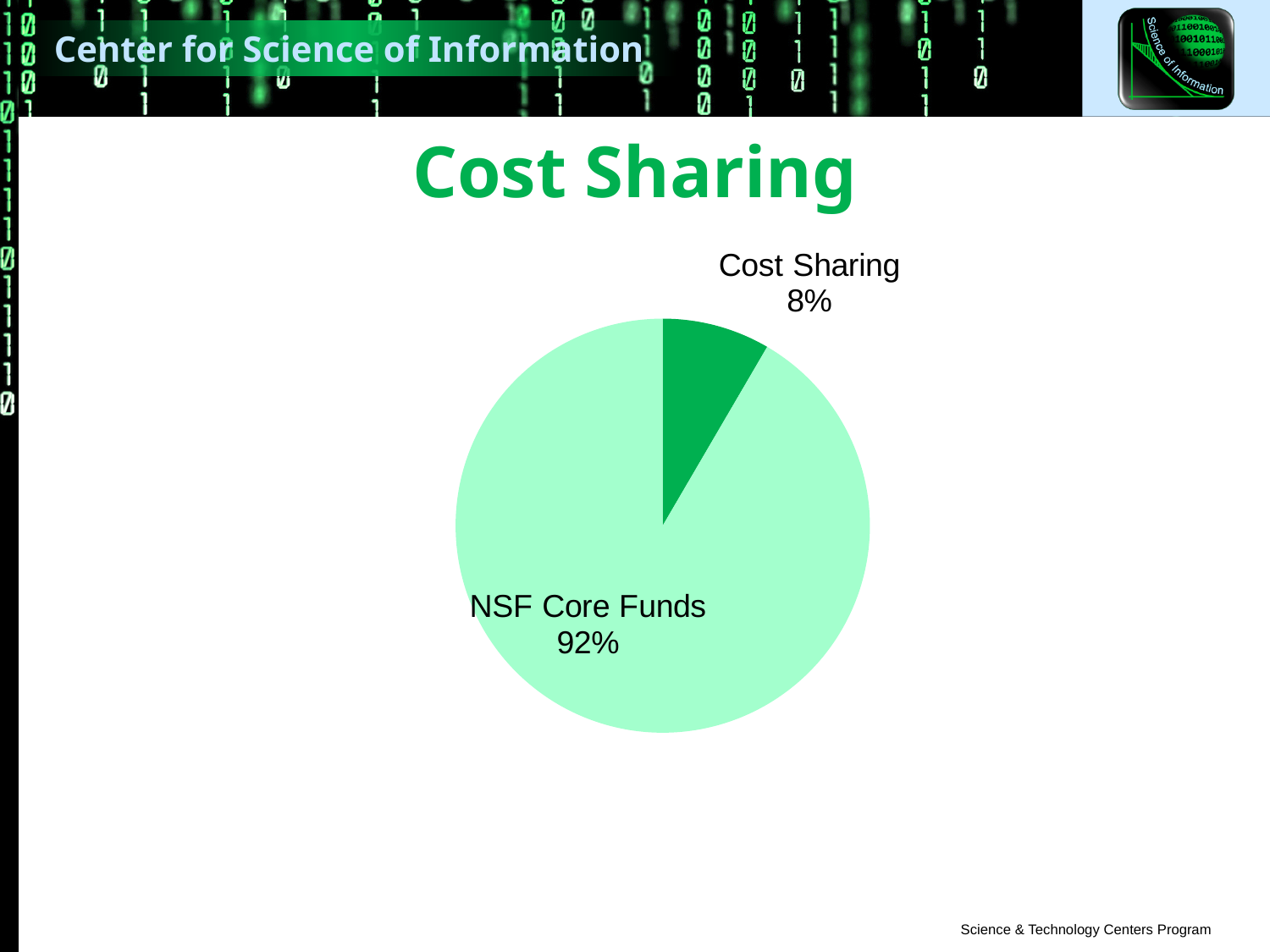
What kind of chart is shown on the slide? pie chart How many slices does the pie chart have? 2 What is the difference in percentage points between NSF Core Funds and Cost Sharing? 84 Which slice is drawn in the darker green colour? Cost Sharing Which slice of the pie is the smallest? Cost Sharing What share of the pie does NSF Core Funds represent? 92% What share of the pie does Cost Sharing represent? 8% Which slice of the pie is the largest? NSF Core Funds Which is larger, the NSF Core Funds slice or the Cost Sharing slice? NSF Core Funds What is the title of the slide containing the pie chart? Cost Sharing